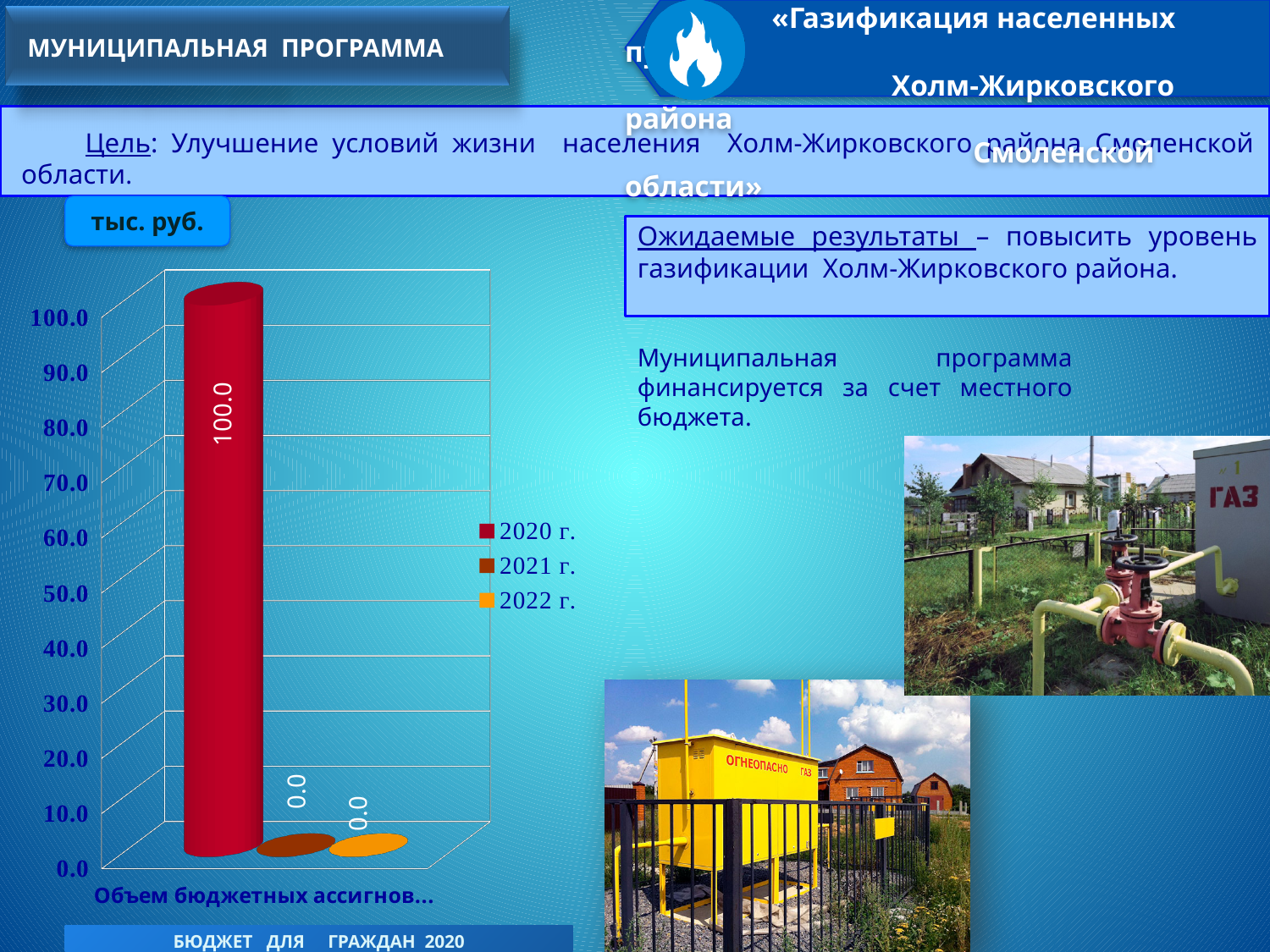
How many series does the chart legend list? 3 What is the value for 2020 г. in the chart? 100.0 What unit is shown in the label above the chart? тыс. руб. What is the difference between the values for 2020 г. and 2021 г.? 100.0 What is the value for 2022 г. in the chart? 0.0 Which year has the highest value in the chart? 2020 г. Is the value for 2020 г. greater or less than 90.0? greater What kind of chart is shown on the slide? bar chart Do the values rise or fall from 2020 г. to 2022 г.? fall What is the value for 2021 г. in the chart? 0.0 Which is larger, the value for 2020 г. or the value for 2022 г.? 2020 г. What colour is the bar for 2020 г. in the chart? red